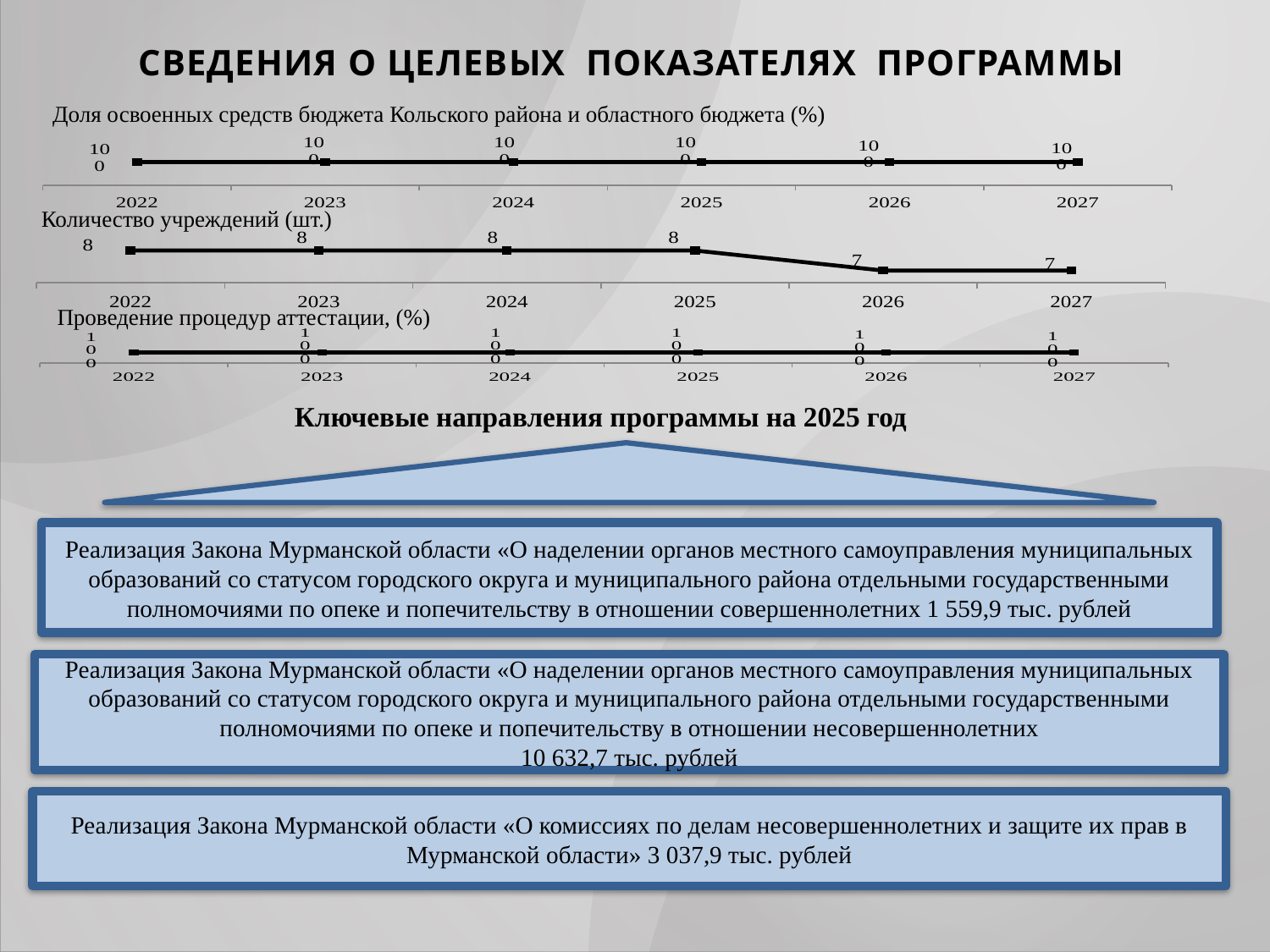
What type of chart is used for "Количество учреждений (шт.)"? line chart In the chart "Проведение процедур аттестации, (%)", what is the value for 2027? 100 In the chart "Количество учреждений (шт.)", what is the difference between the values for 2025 and 2026? 1 In the chart "Доля освоенных средств бюджета Кольского района и областного бюджета (%)", what is the value for 2023? 100 In the chart "Количество учреждений (шт.)", what is the value for 2027? 7 In the chart "Количество учреждений (шт.)", what is the value for 2026? 7 How many years are plotted in the chart "Количество учреждений (шт.)"? 6 In the chart "Количество учреждений (шт.)", which is larger, the value for 2024 or the value for 2027? 2024 How many years are plotted in the chart "Проведение процедур аттестации, (%)"? 6 How many charts are shown on the slide? 3 In the chart "Количество учреждений (шт.)", what is the value for 2022? 8 In the chart "Количество учреждений (шт.)", do the values rise or fall from 2022 to 2027? fall